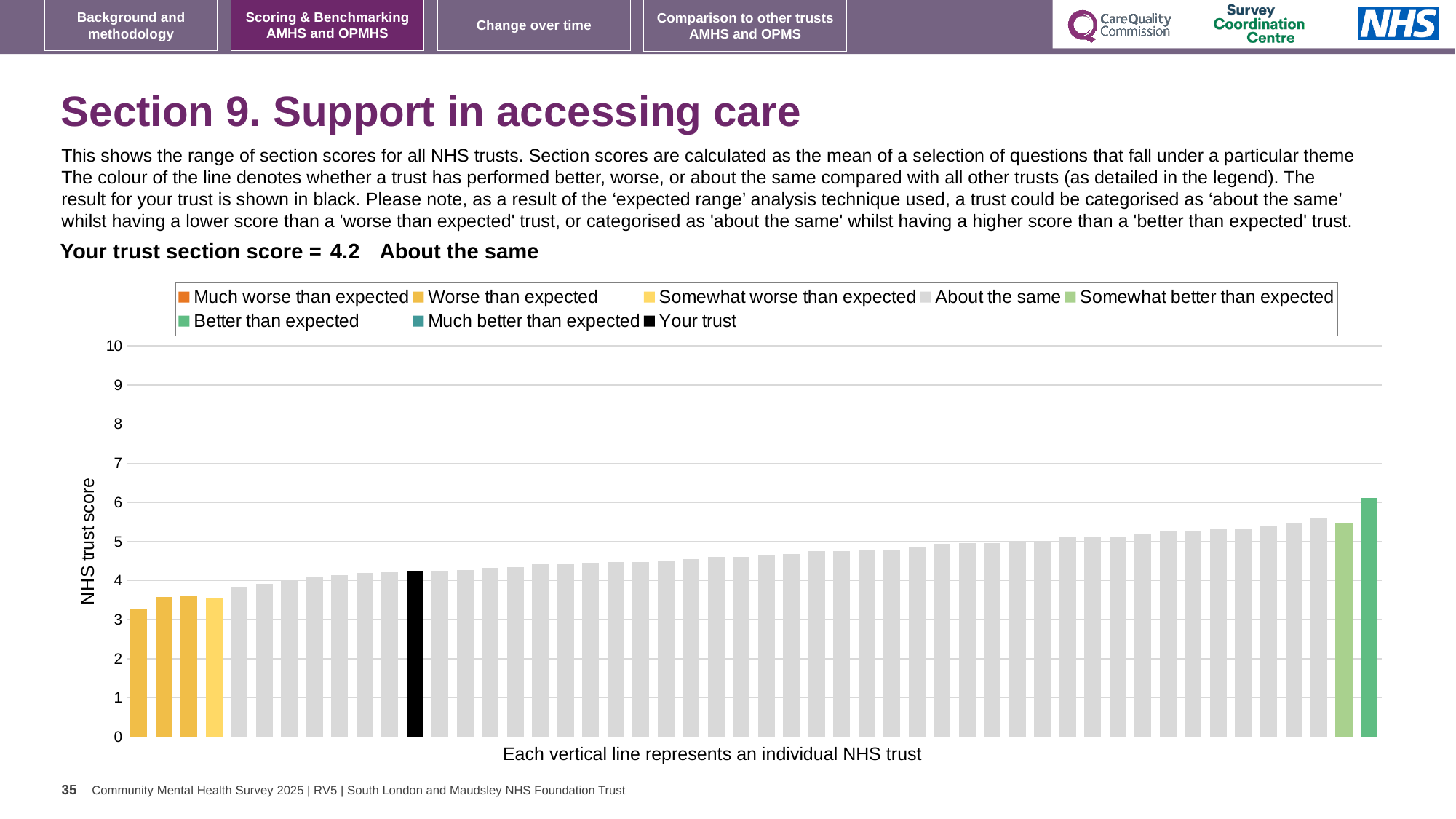
Is the value of the leftmost bar greater or less than 4? less How many entries does the chart legend list? 8 Do the bar values rise or fall from left to right along the x axis? rise Which is larger, the leftmost bar or the black 'Your trust' bar? the black 'Your trust' bar Which category is your trust placed in for this section? About the same What kind of chart is shown on the slide? bar chart Is the value of the rightmost bar greater or less than 5? greater What colour is used for the 'Your trust' bar in the legend? black What is your trust's section score as printed on the slide? 4.2 What is the label on the vertical axis of the chart? NHS trust score How many bars in the chart are coloured green? 2 Is the value for your trust (the black bar) greater or less than 4? greater